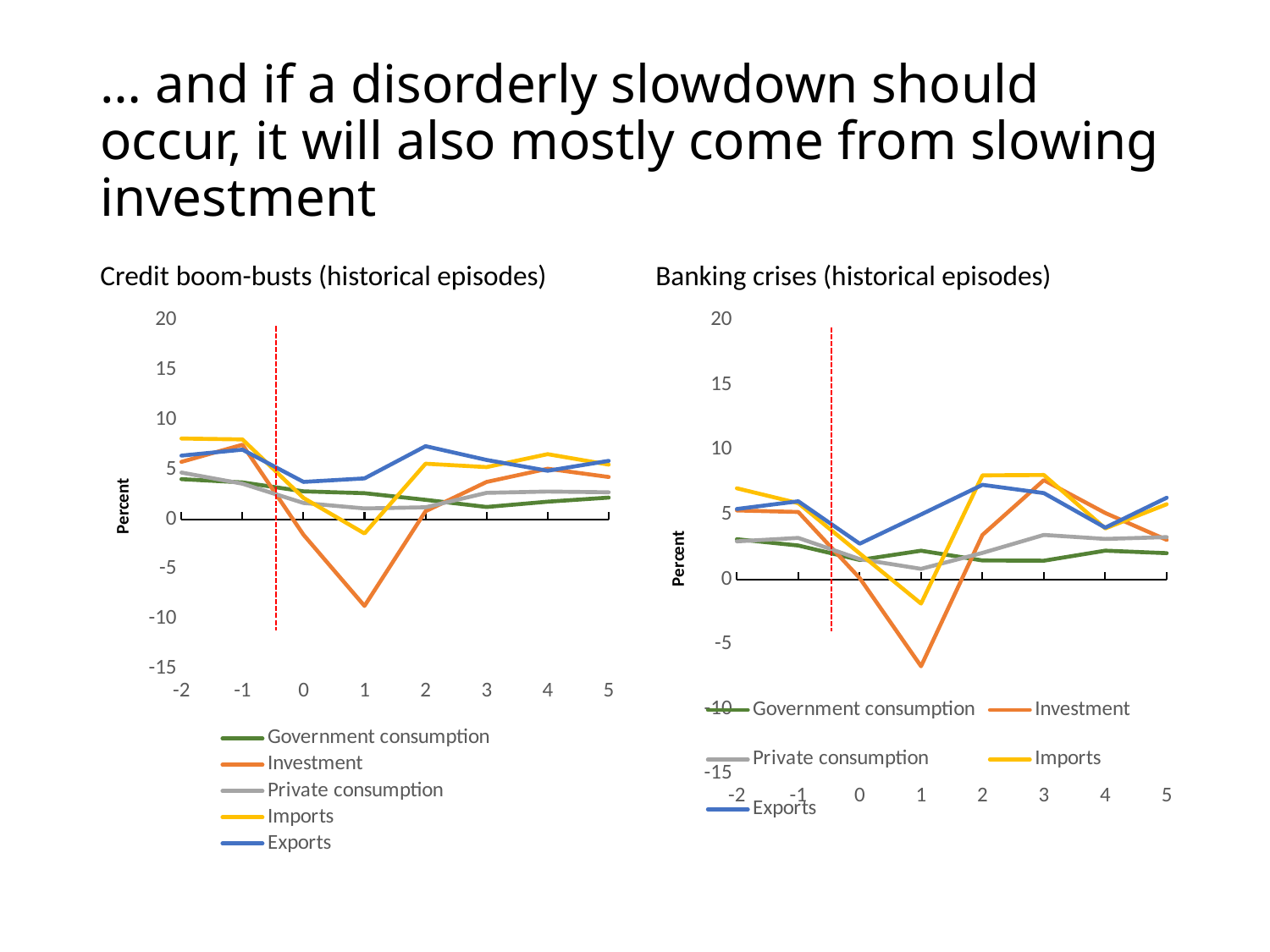
In the 'Credit boom-busts (historical episodes)' chart, which series has the lowest value at x = 1? Investment What kind of chart is the 'Credit boom-busts (historical episodes)' chart? line chart In the 'Banking crises (historical episodes)' chart, which series has the lowest value at x = 1? Investment In the 'Banking crises (historical episodes)' chart, is the value for Investment at x = 1 greater or less than -5? less In the 'Credit boom-busts (historical episodes)' chart, does the Investment line rise or fall from x = 0 to x = 1? fall How many points are on the x axis of the 'Credit boom-busts (historical episodes)' chart? 8 In the 'Banking crises (historical episodes)' chart, is the value for Exports at x = 2 greater or less than 5? greater In the 'Credit boom-busts (historical episodes)' chart, which is larger at x = 1: Exports or Investment? Exports In the 'Credit boom-busts (historical episodes)' chart, is the value for Imports at x = -2 greater or less than 5? greater How many series does the legend of the 'Banking crises (historical episodes)' chart list? 5 What is the y-axis label on the 'Banking crises (historical episodes)' chart? Percent